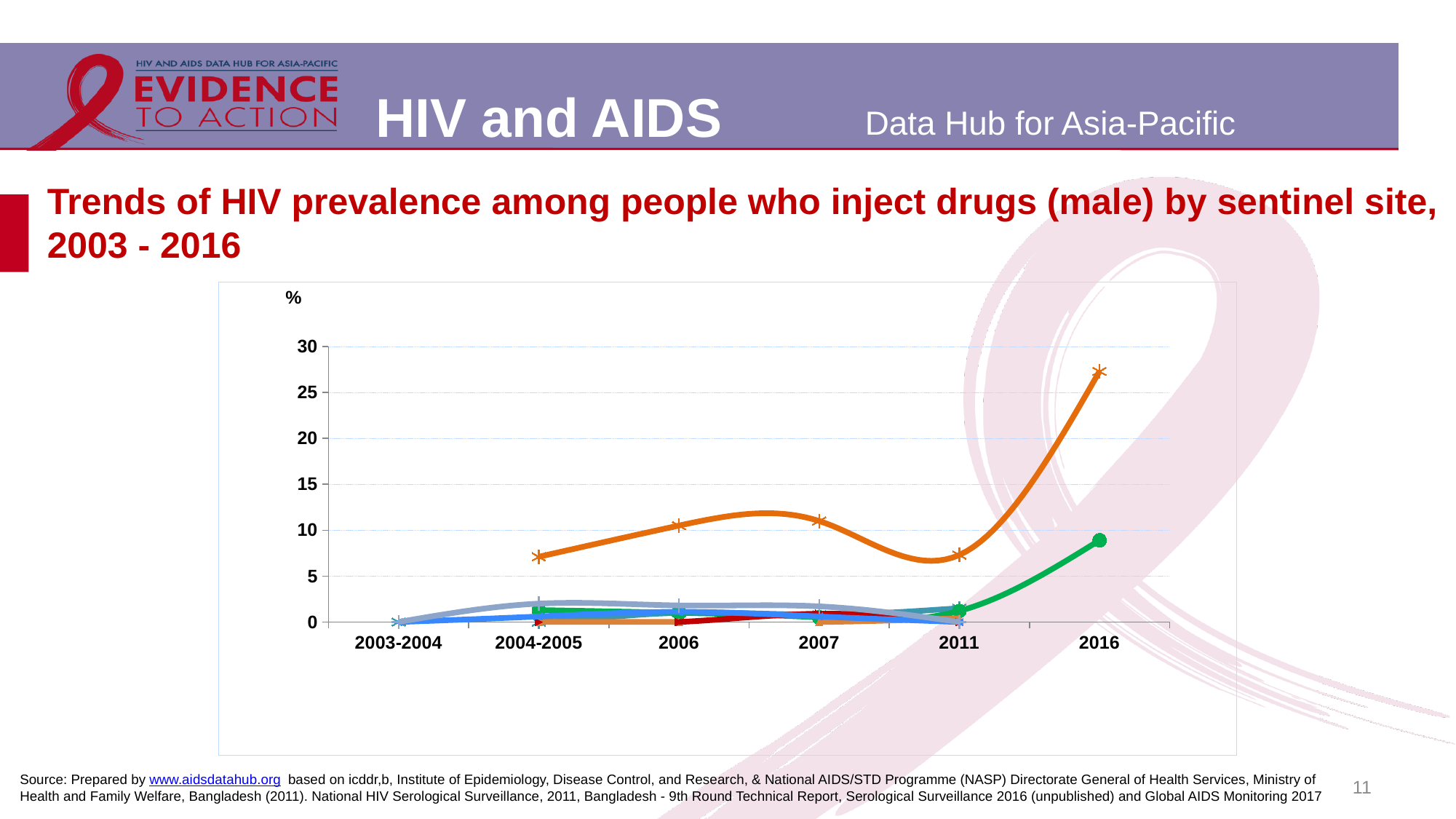
Does the orange line rise or fall between 2007 and 2011? fall In which year does the orange line reach its highest value? 2016 Is the value of the green line in 2016 greater or less than 5? greater What is the first time period labelled on the x axis? 2003-2004 Is the value of the orange line in 2016 greater or less than 25? greater Does the orange line rise or fall between 2011 and 2016? rise What kind of chart is shown on the slide? line chart Is the value of the green line in 2011 greater or less than 5? less What unit is shown on the y axis of the chart? % How many time periods are labelled on the x axis of the chart? 6